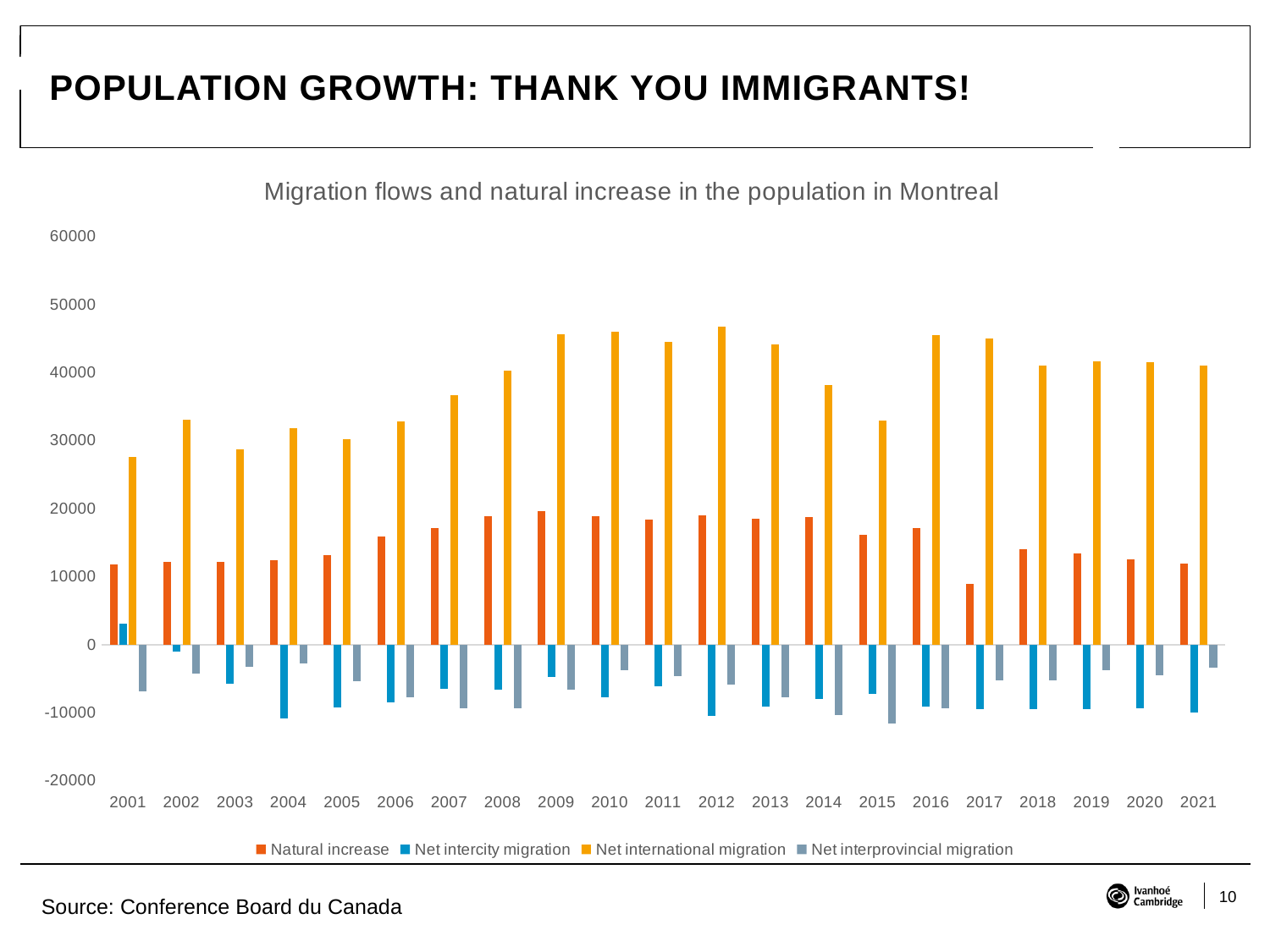
How many years are shown on the x axis? 21 Does Net international migration rise or fall from 2001 to 2009? Rise Is the value for Net international migration in 2001 greater or less than 30000? less Which year has the lowest value for Net international migration? 2001 Is the value for Net international migration in 2012 greater or less than 40000? greater Is the value for Net intercity migration in 2001 greater or less than 0? greater What kind of chart is shown on the slide? Bar chart How many series does the legend list? 4 Which year has the lowest value for Natural increase? 2017 What is the title of the chart? Migration flows and natural increase in the population in Montreal Which is larger in 2021: Natural increase or Net international migration? Net international migration